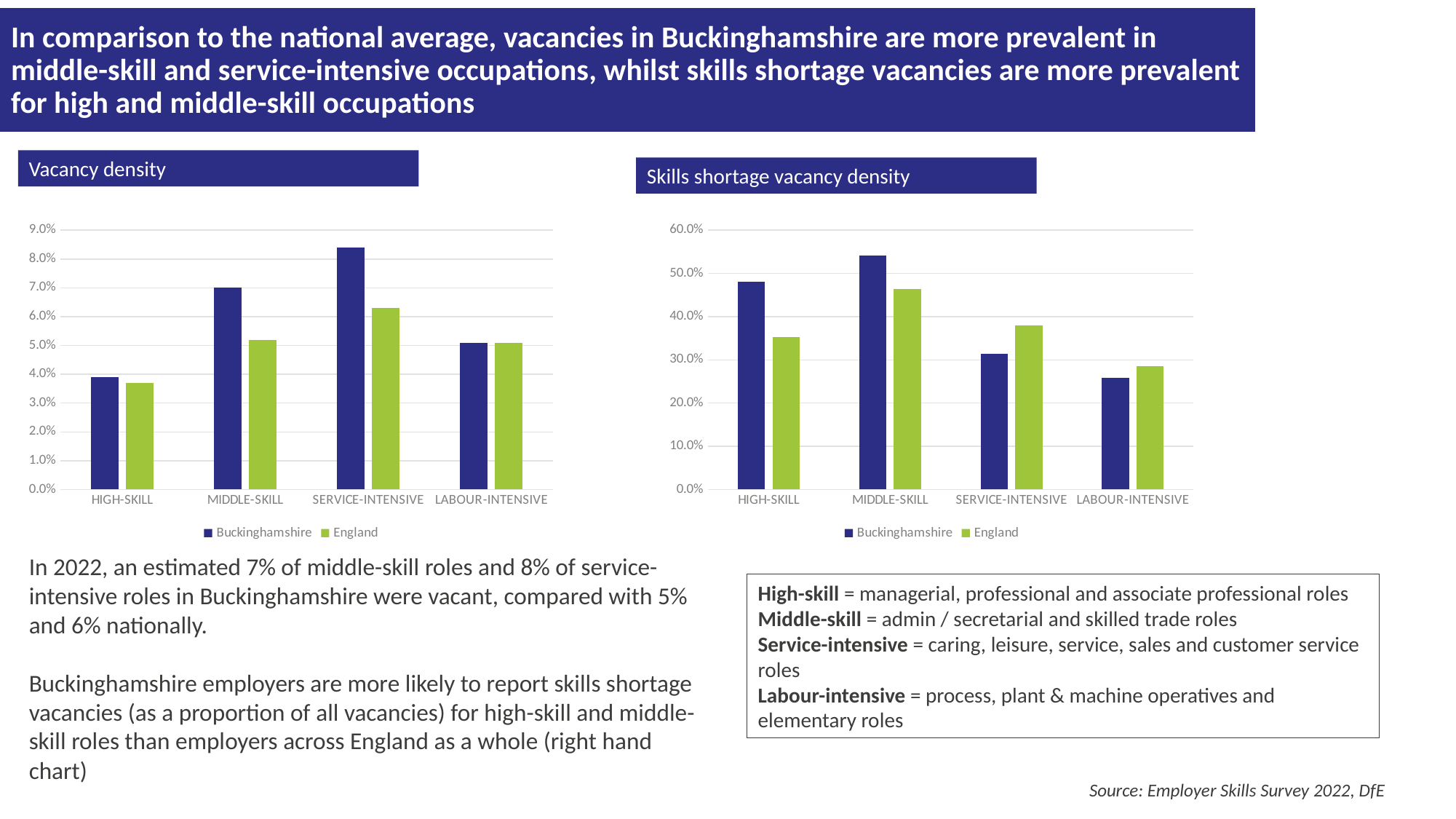
How many series does the legend of the Vacancy density chart list? 2 In the Skills shortage vacancy density chart, which category has the lowest value for Buckinghamshire? Labour-intensive In the Vacancy density chart, which is larger for Middle-skill: Buckinghamshire or England? Buckinghamshire In the Skills shortage vacancy density chart, which category has the highest value for Buckinghamshire? Middle-skill In the Skills shortage vacancy density chart, what colour are the England bars? Green In the Vacancy density chart, which category has the highest value for Buckinghamshire? Service-intensive In the Vacancy density chart, is the Buckinghamshire value for Service-intensive greater or less than 8.0%? greater What kind of chart is the Vacancy density chart? Bar chart In the Skills shortage vacancy density chart, is the Buckinghamshire value for Middle-skill greater or less than 50.0%? greater In the Skills shortage vacancy density chart, which is larger for Service-intensive: Buckinghamshire or England? England How many occupation categories are shown on the x axis of the Skills shortage vacancy density chart? 4 In the Vacancy density chart, which category has the lowest value for Buckinghamshire? High-skill